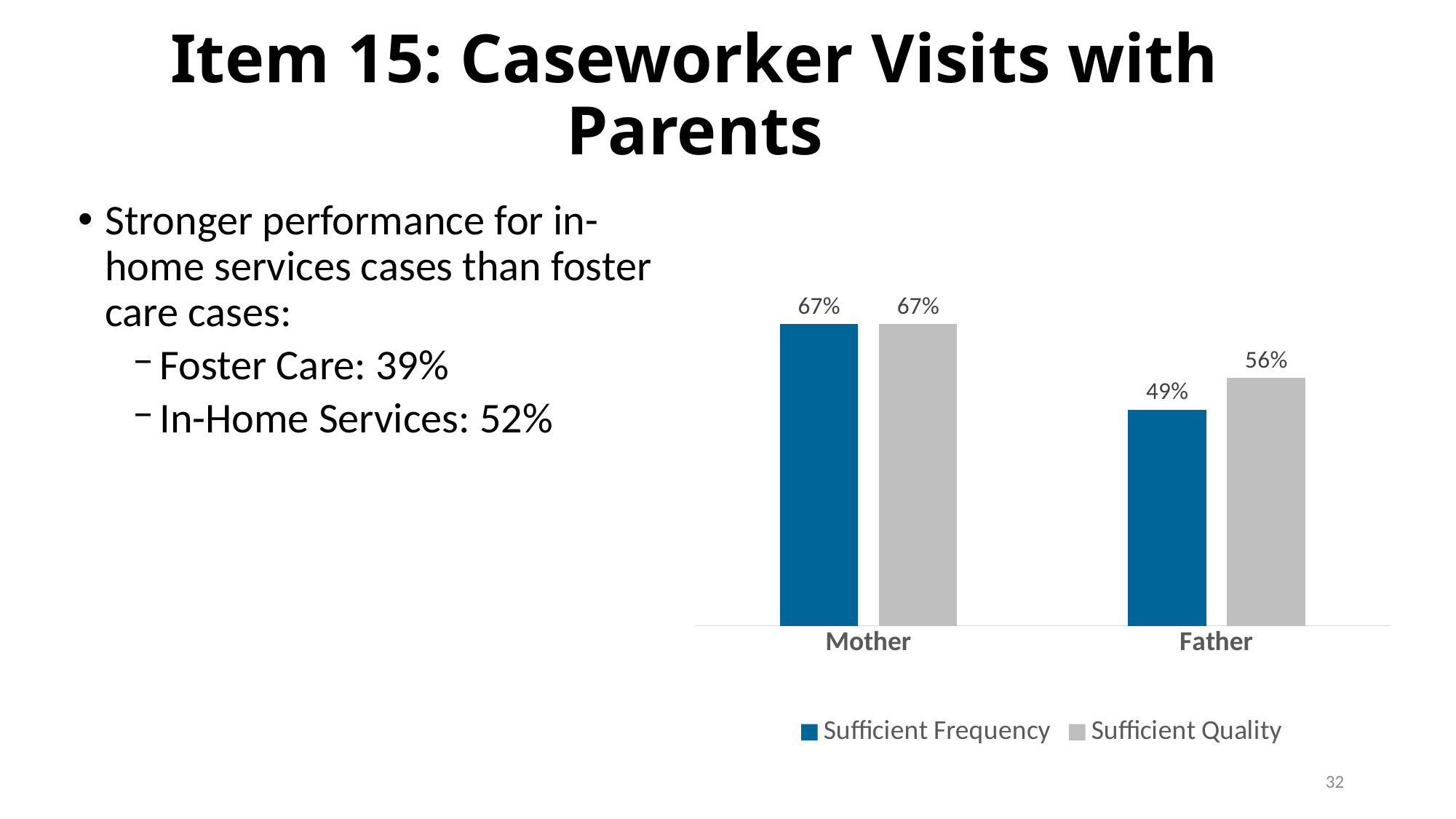
What is the Sufficient Quality value for Father? 56% What is the difference between the Sufficient Frequency values for Mother and Father? 18% How many categories are shown on the x axis of the chart? 2 What is the Sufficient Frequency value for Father? 49% How many series does the chart legend list? 2 Which category has the lowest Sufficient Frequency value? Father What kind of chart is shown on the slide? Bar chart For Father, which is larger: Sufficient Frequency or Sufficient Quality? Sufficient Quality What is the Sufficient Frequency value for Mother? 67% What is the Sufficient Quality value for Mother? 67% What is the difference between the Sufficient Quality and Sufficient Frequency values for Father? 7% Which category has the highest Sufficient Quality value? Mother